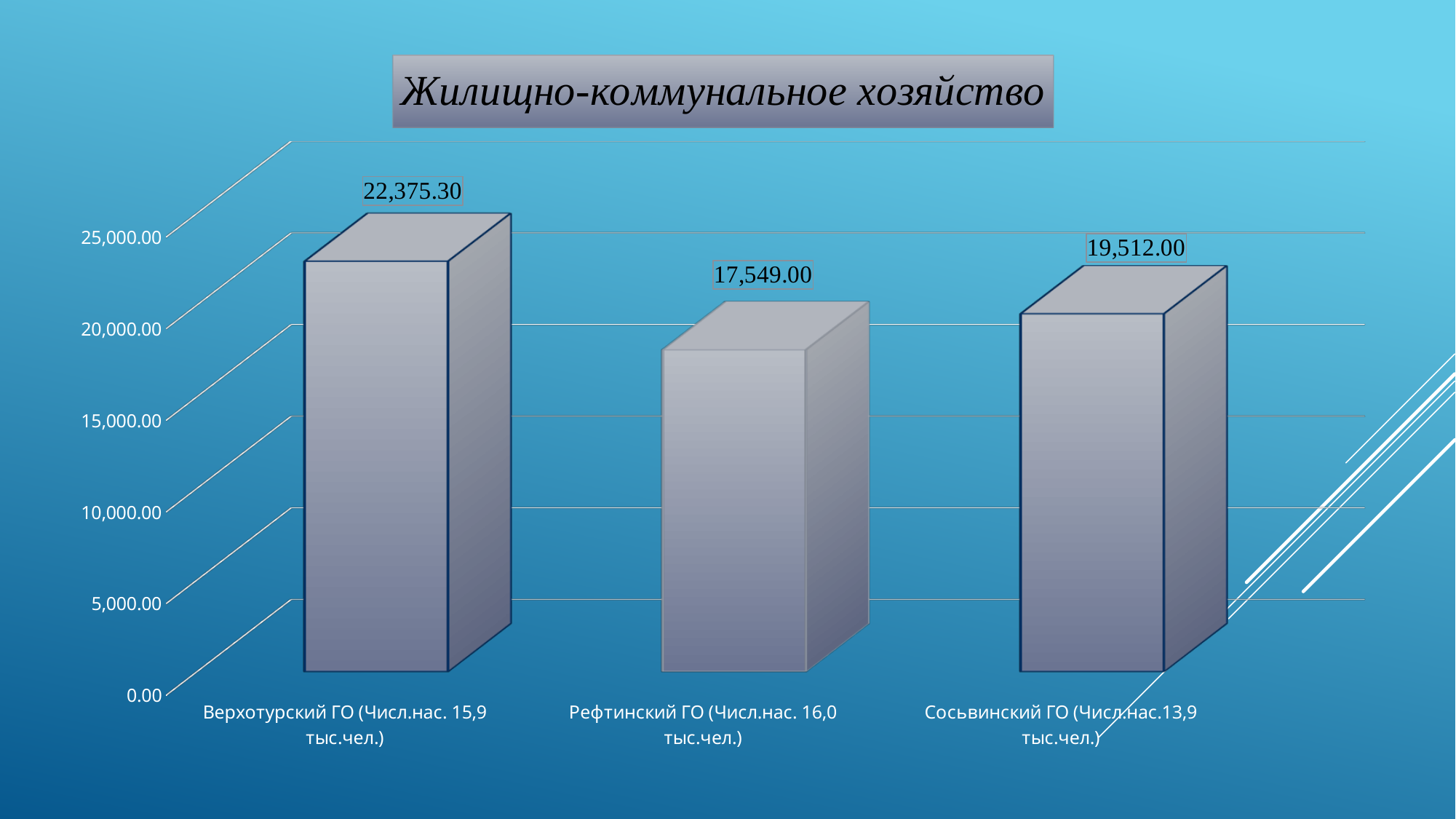
What is the value for Верхотурский ГО? 22,375.30 What is the value for Рефтинский ГО? 17,549.00 Which category has the lowest value? Рефтинский ГО What is the title of the slide? Жилищно-коммунальное хозяйство What is the value for Сосьвинский ГО? 19,512.00 Is the value for Рефтинский ГО greater or less than 20,000.00? less Which category has the highest value? Верхотурский ГО Which is larger, the value for Сосьвинский ГО or the value for Рефтинский ГО? Сосьвинский ГО What is the difference between the values for Сосьвинский ГО and Рефтинский ГО? 1,963.00 What is the difference between the values for Верхотурский ГО and Рефтинский ГО? 4,826.30 How many categories are shown in the chart? 3 What kind of chart is shown on the slide? bar chart